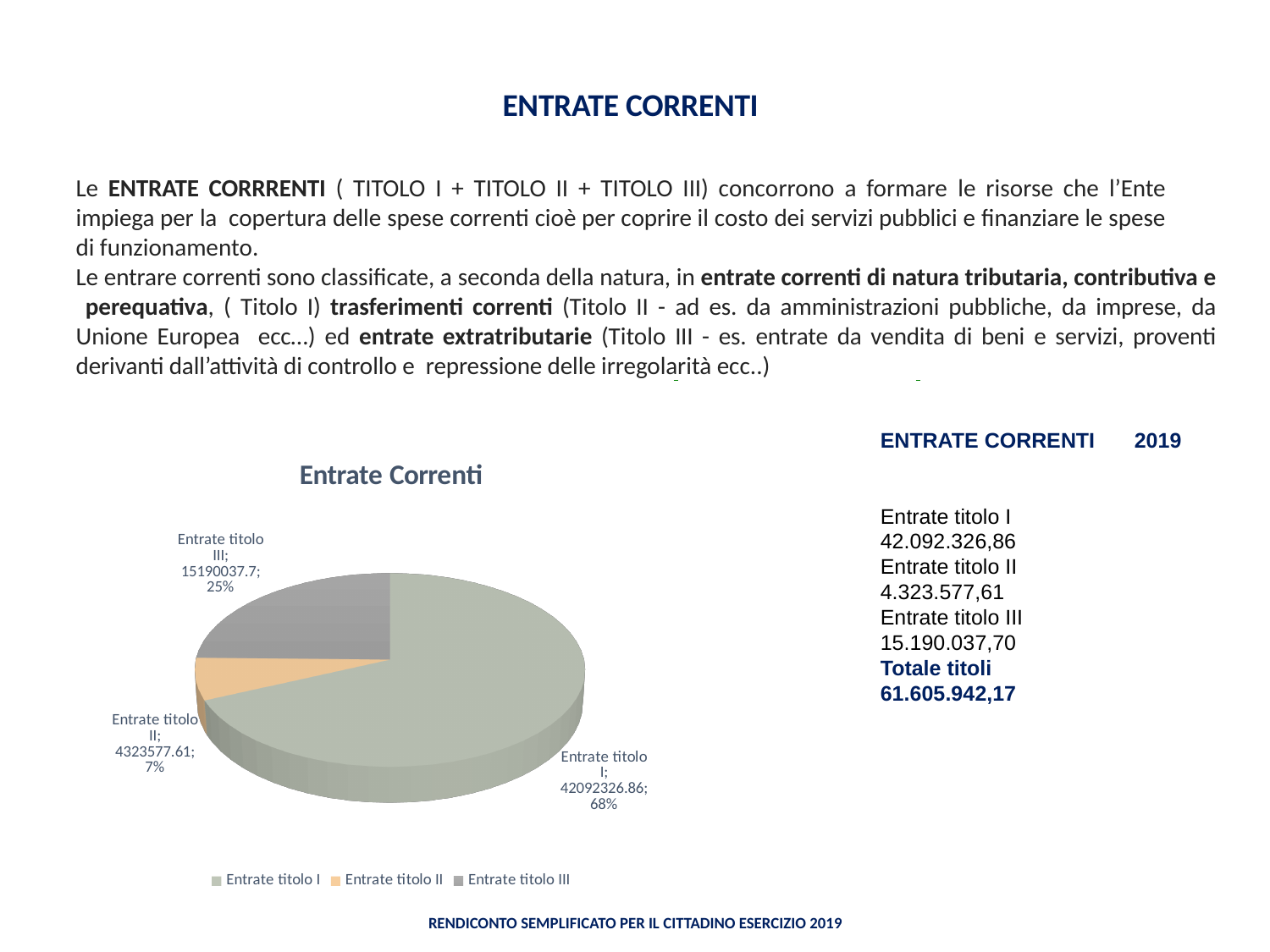
How many entries does the chart legend list? 3 Which category has the smallest slice of the pie? Entrate titolo II What value is shown for Entrate titolo III in the chart? 15190037.7 Which category has the largest slice of the pie? Entrate titolo I What share of the pie does Entrate titolo I represent? 68% What share of the pie does Entrate titolo III represent? 25% How many slices does the pie chart have? 3 Which is larger, the slice for Entrate titolo II or the slice for Entrate titolo III? Entrate titolo III What kind of chart is shown on the slide? Pie chart What value is shown for Entrate titolo I in the chart? 42092326.86 What is the title of the chart? Entrate Correnti What value is shown for Entrate titolo II in the chart? 4323577.61